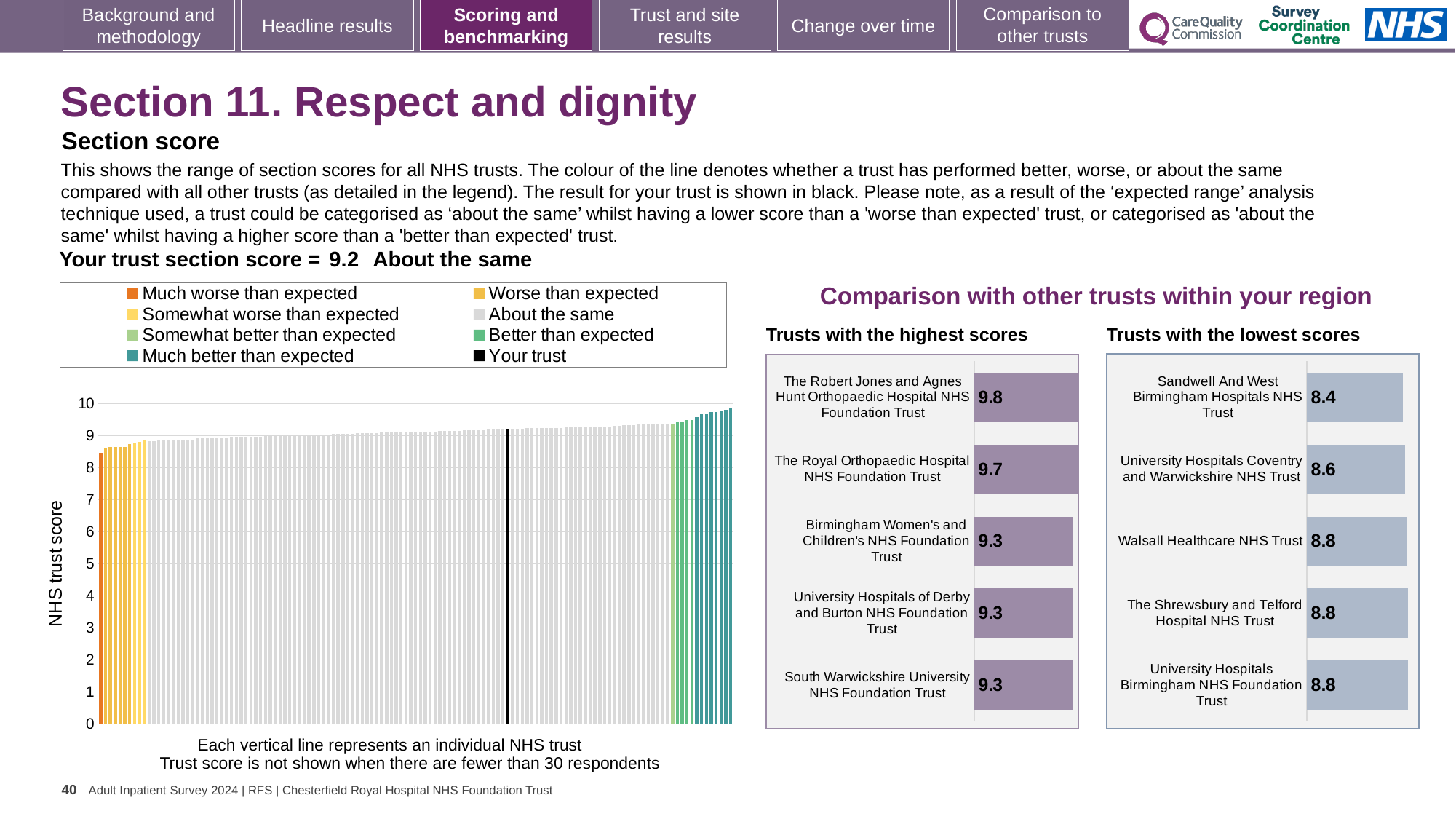
What kind of chart is the large chart on the left showing NHS trust scores? bar chart How many entries does the legend above the large chart on the left list? 8 In the 'Trusts with the lowest scores' chart, what is the score for Sandwell And West Birmingham Hospitals NHS Trust? 8.4 In the large chart on the left, do the trust scores rise or fall from left to right along the x axis? rise In the 'Trusts with the lowest scores' chart, which trust has the lowest score? Sandwell And West Birmingham Hospitals NHS Trust What is the section score for your trust, as stated on the slide? 9.2 In the 'Trusts with the highest scores' chart, what is the score for The Robert Jones and Agnes Hunt Orthopaedic Hospital NHS Foundation Trust? 9.8 How many trusts are shown in the 'Trusts with the highest scores' chart? 5 What is the label on the y axis of the large chart on the left? NHS trust score In the 'Trusts with the highest scores' chart, which trust has the highest score? The Robert Jones and Agnes Hunt Orthopaedic Hospital NHS Foundation Trust In the 'Trusts with the highest scores' chart, what is the difference between the score of The Royal Orthopaedic Hospital NHS Foundation Trust and South Warwickshire University NHS Foundation Trust? 0.4 In the 'Trusts with the lowest scores' chart, which has the larger score: Walsall Healthcare NHS Trust or University Hospitals Coventry and Warwickshire NHS Trust? Walsall Healthcare NHS Trust